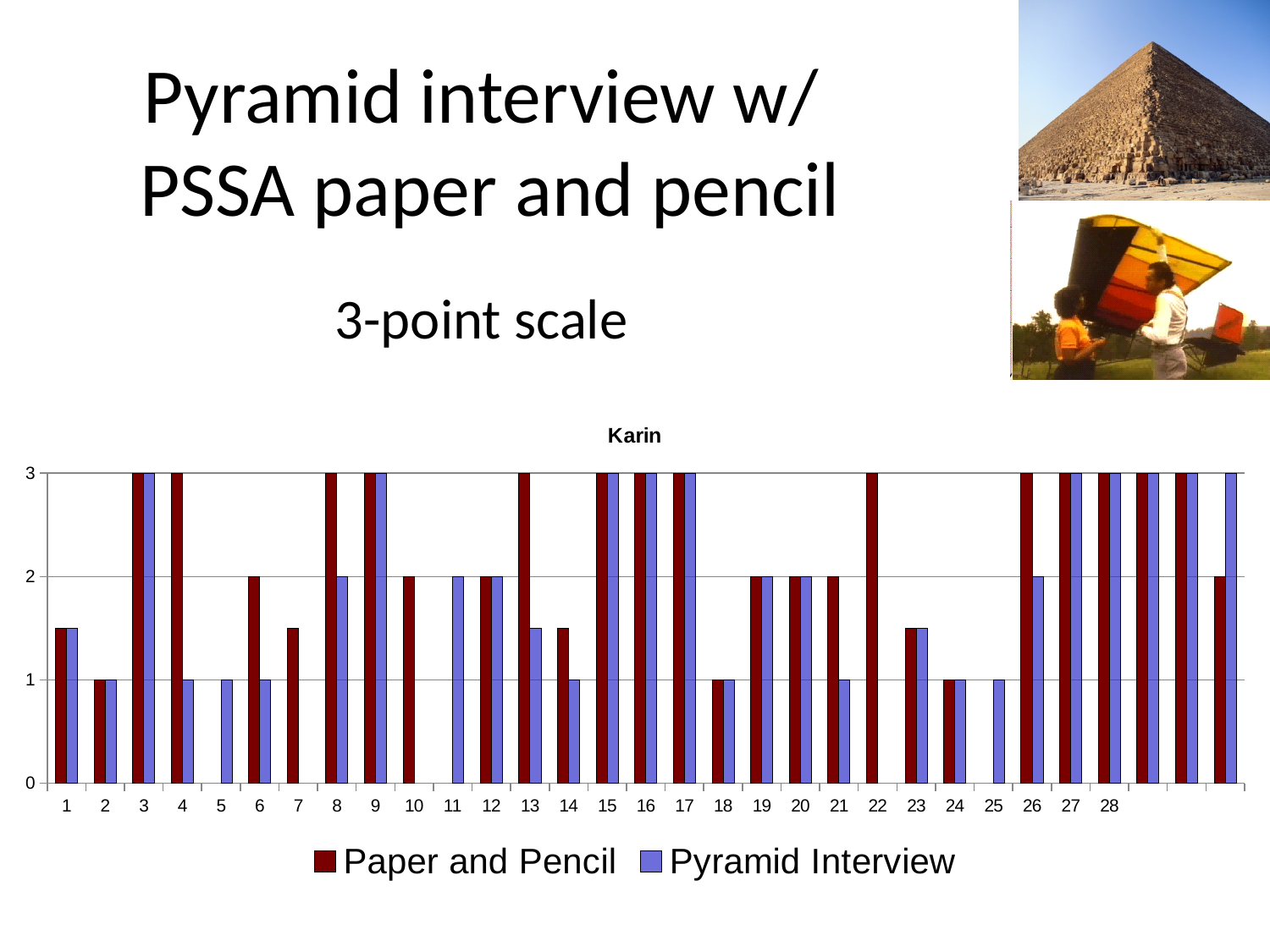
What is the Pyramid Interview value for category 26? 2 How many series does the chart legend list? 2 What is the Pyramid Interview value for category 4? 1 What is the Paper and Pencil value for category 22? 3 What is the title of the chart? Karin What is the Paper and Pencil value for category 4? 3 Is the Paper and Pencil value for category 7 greater or less than 2? less What kind of chart is shown on the slide? bar chart What is the difference between the Paper and Pencil and Pyramid Interview values for category 21? 1 Is the Pyramid Interview value for category 13 greater or less than 1? greater Which is larger for category 6, Paper and Pencil or Pyramid Interview? Paper and Pencil What is the Paper and Pencil value for category 12? 2